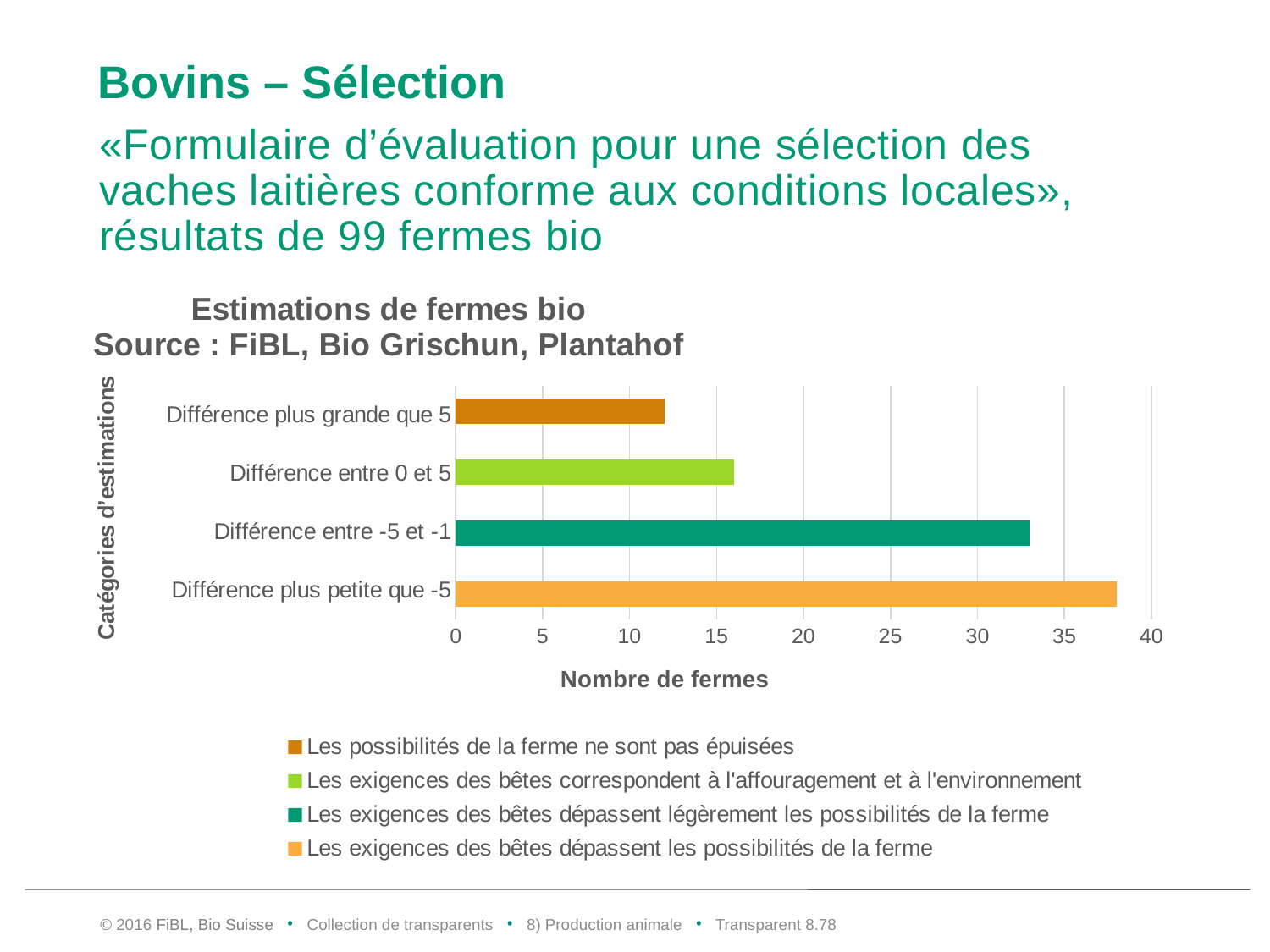
How many entries does the chart's legend list? 4 What is the title of the chart? Estimations de fermes bio Source : FiBL, Bio Grischun, Plantahof What is the label of the x axis of the chart? Nombre de fermes Which category has the highest number of farms? Différence plus petite que -5 How many categories are plotted on the y axis of the chart? 4 Is the value for "Différence entre -5 et -1" greater or less than 30? greater Which has more farms: "Différence entre 0 et 5" or "Différence entre -5 et -1"? Différence entre -5 et -1 What kind of chart is shown on the slide? bar chart Is the value for "Différence plus grande que 5" greater or less than 15? less Is the value for "Différence plus petite que -5" greater or less than 35? greater Which category has the lowest number of farms? Différence plus grande que 5